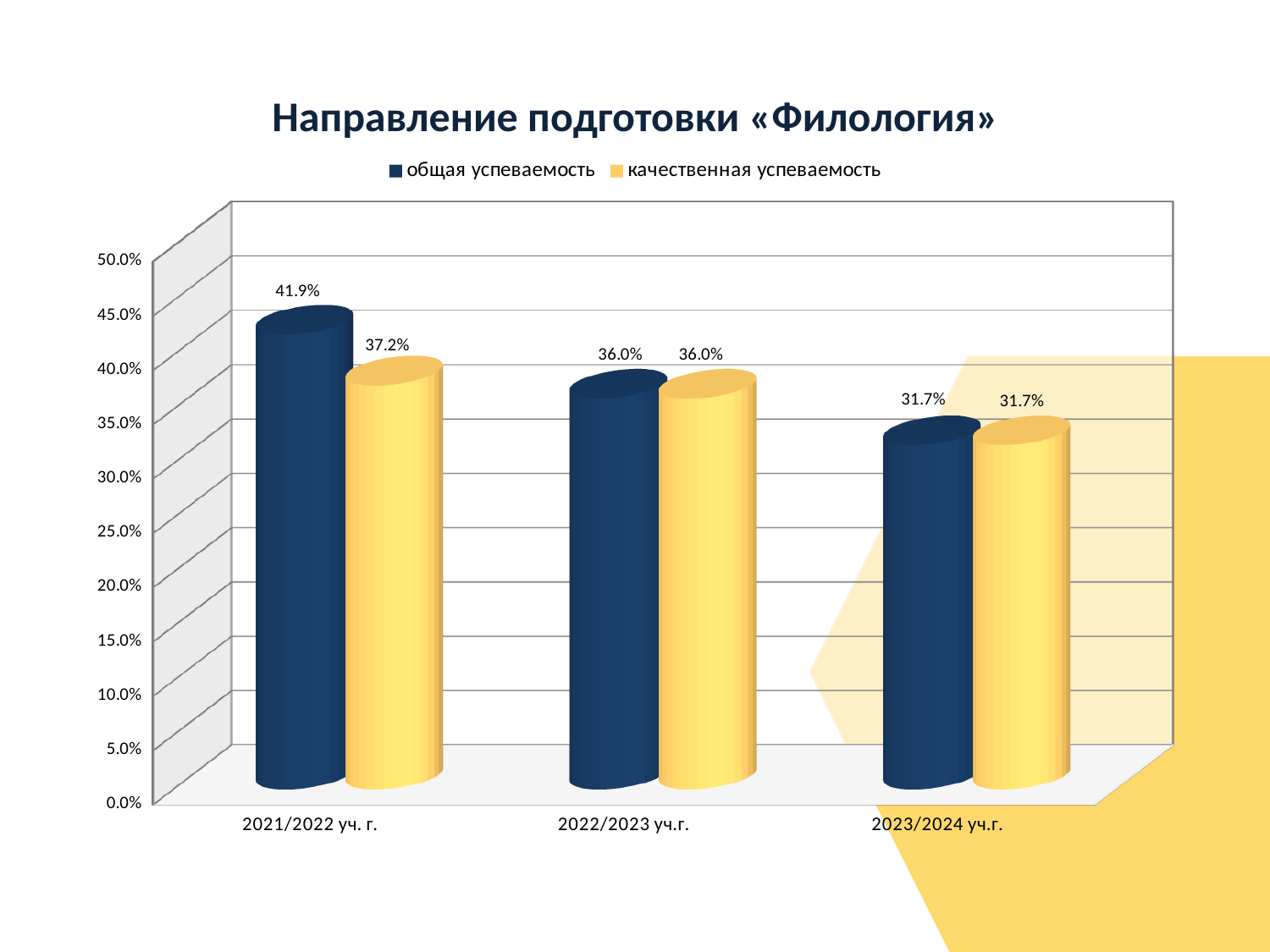
How many academic years are shown on the x axis? 3 In which academic year is общая успеваемость highest? 2021/2022 уч. г. How many series does the legend list? 2 What kind of chart is shown on the slide? bar chart Which is larger in 2021/2022 уч. г.: общая успеваемость or качественная успеваемость? общая успеваемость What is the difference between общая успеваемость and качественная успеваемость in 2021/2022 уч. г.? 4.7% What is the value of общая успеваемость for 2021/2022 уч. г.? 41.9% What is the value of общая успеваемость for 2023/2024 уч.г.? 31.7% In which academic year is качественная успеваемость lowest? 2023/2024 уч.г. What is the value of качественная успеваемость for 2021/2022 уч. г.? 37.2% Does общая успеваемость rise or fall from 2021/2022 уч. г. to 2023/2024 уч.г.? fall What is the value of качественная успеваемость for 2022/2023 уч.г.? 36.0%